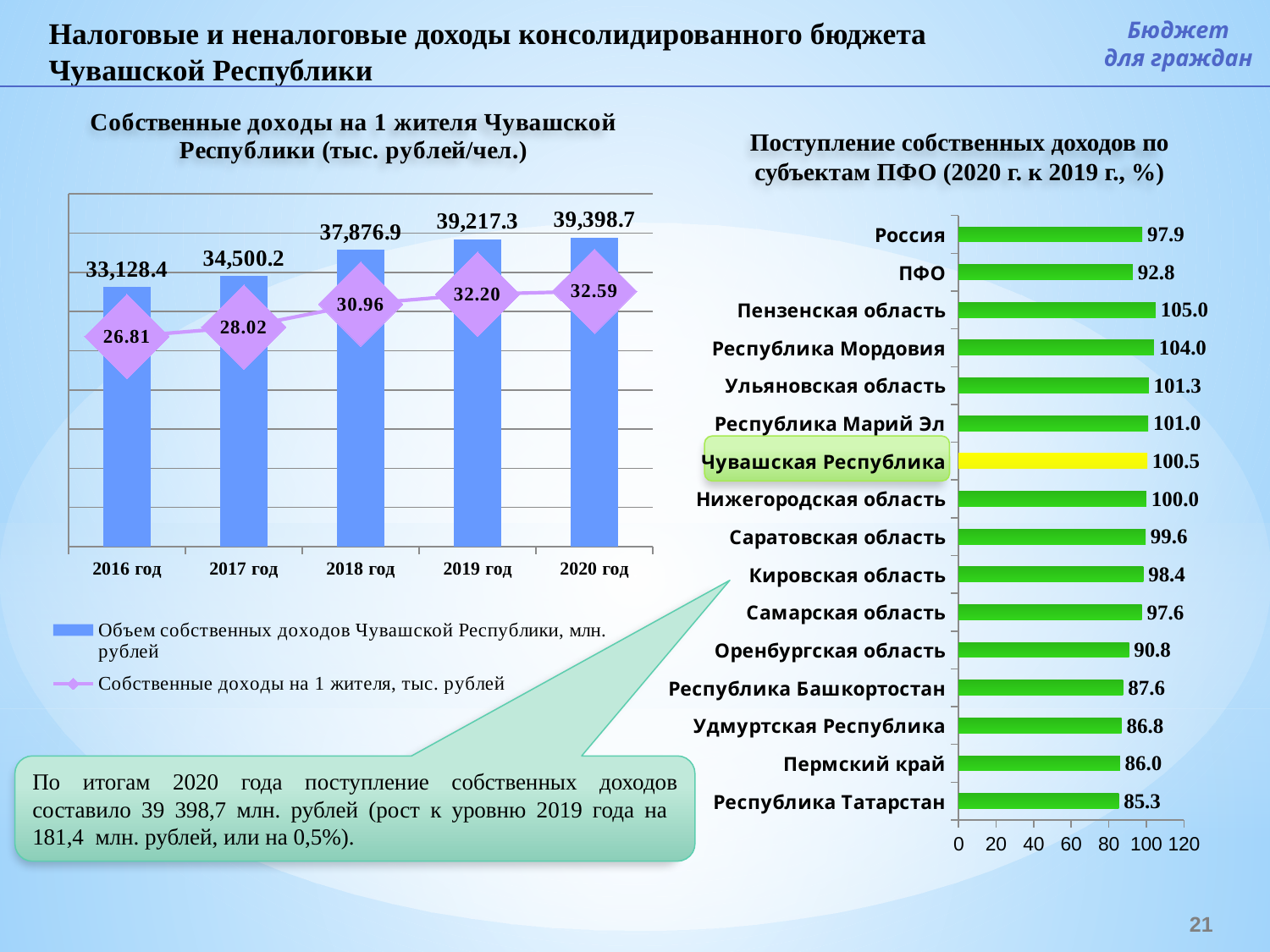
In the left chart, what is the difference between the bar values for 2020 год and 2019 год? 181.4 In the right chart (Поступление собственных доходов по субъектам ПФО), what is the value for Чувашская Республика? 100.5 In the left chart, do the bar values rise or fall from 2016 год to 2020 год? rise In the left chart, how many years are shown on the x axis? 5 In the right chart, which region has the lowest value? Республика Татарстан In the right chart, which is larger: the value for Россия or the value for ПФО? Россия What type of chart is the right chart (Поступление собственных доходов по субъектам ПФО)? bar chart In the right chart, which region has the highest value? Пензенская область In the left chart, how many series does the legend list? 2 In the left chart (Собственные доходы на 1 жителя Чувашской Республики), what is the value of the bar for 2020 год? 39,398.7 In the left chart, what is the value of the line marker for 2016 год? 26.81 In the right chart, what is the difference between the values for Республика Мордовия and Удмуртская Республика? 17.2